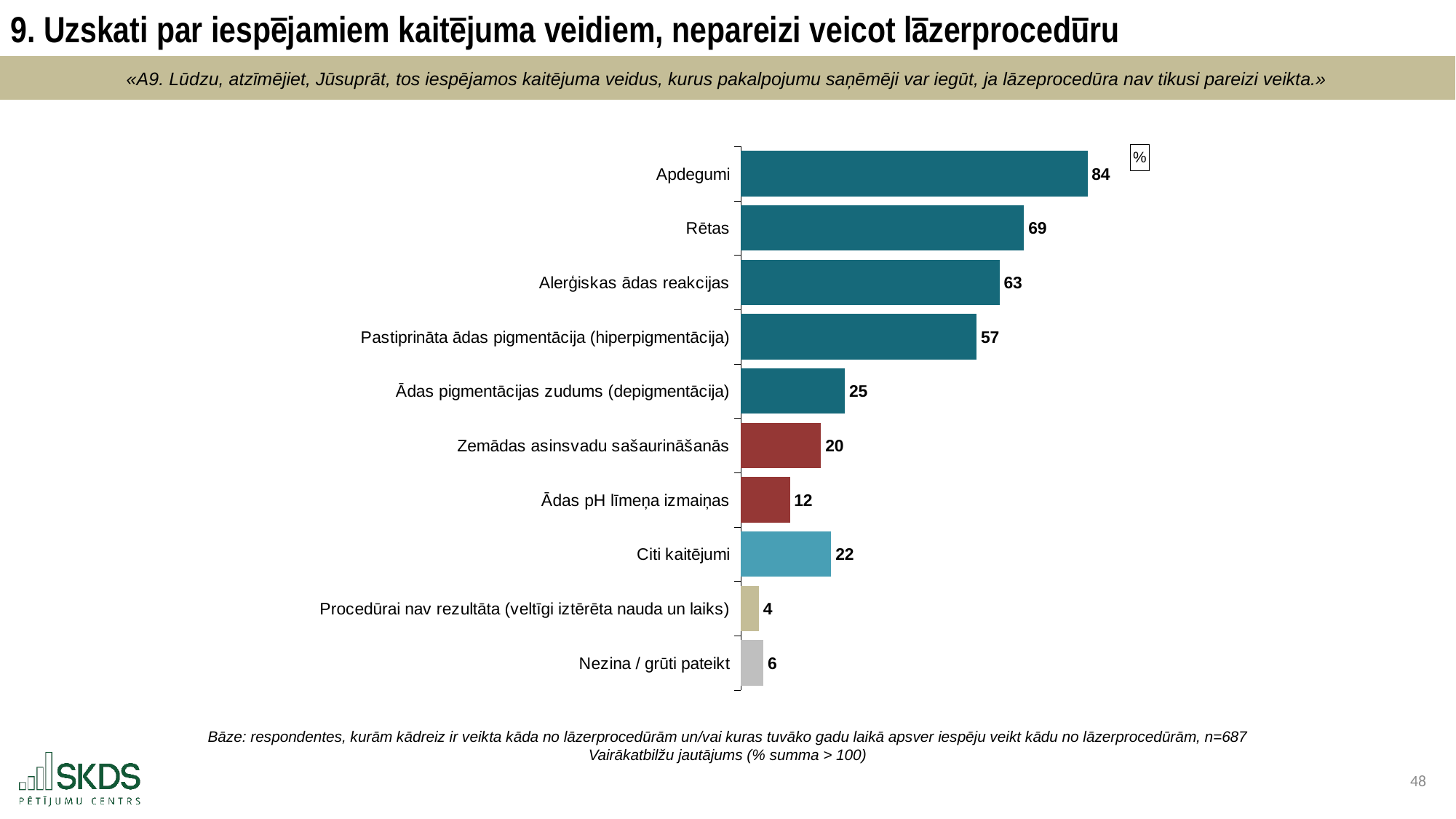
How many categories are shown in the chart? 10 What is the value for Ādas pH līmeņa izmaiņas? 12 What kind of chart is shown on the slide? Bar chart What is the value for Apdegumi? 84 What is the difference between the values for Apdegumi and Pastiprināta ādas pigmentācija (hiperpigmentācija)? 27 What is the difference between the values for Rētas and Alerģiskas ādas reakcijas? 6 Which category has the lowest value? Procedūrai nav rezultāta (veltīgi iztērēta nauda un laiks) Which is larger, the value for Ādas pigmentācijas zudums (depigmentācija) or the value for Zemādas asinsvadu sašaurināšanās? Ādas pigmentācijas zudums (depigmentācija) What is the value for Citi kaitējumi? 22 Which category has the highest value? Apdegumi What unit is indicated in the box at the top right of the chart? % Which is larger, the value for Nezina / grūti pateikt or the value for Procedūrai nav rezultāta (veltīgi iztērēta nauda un laiks)? Nezina / grūti pateikt